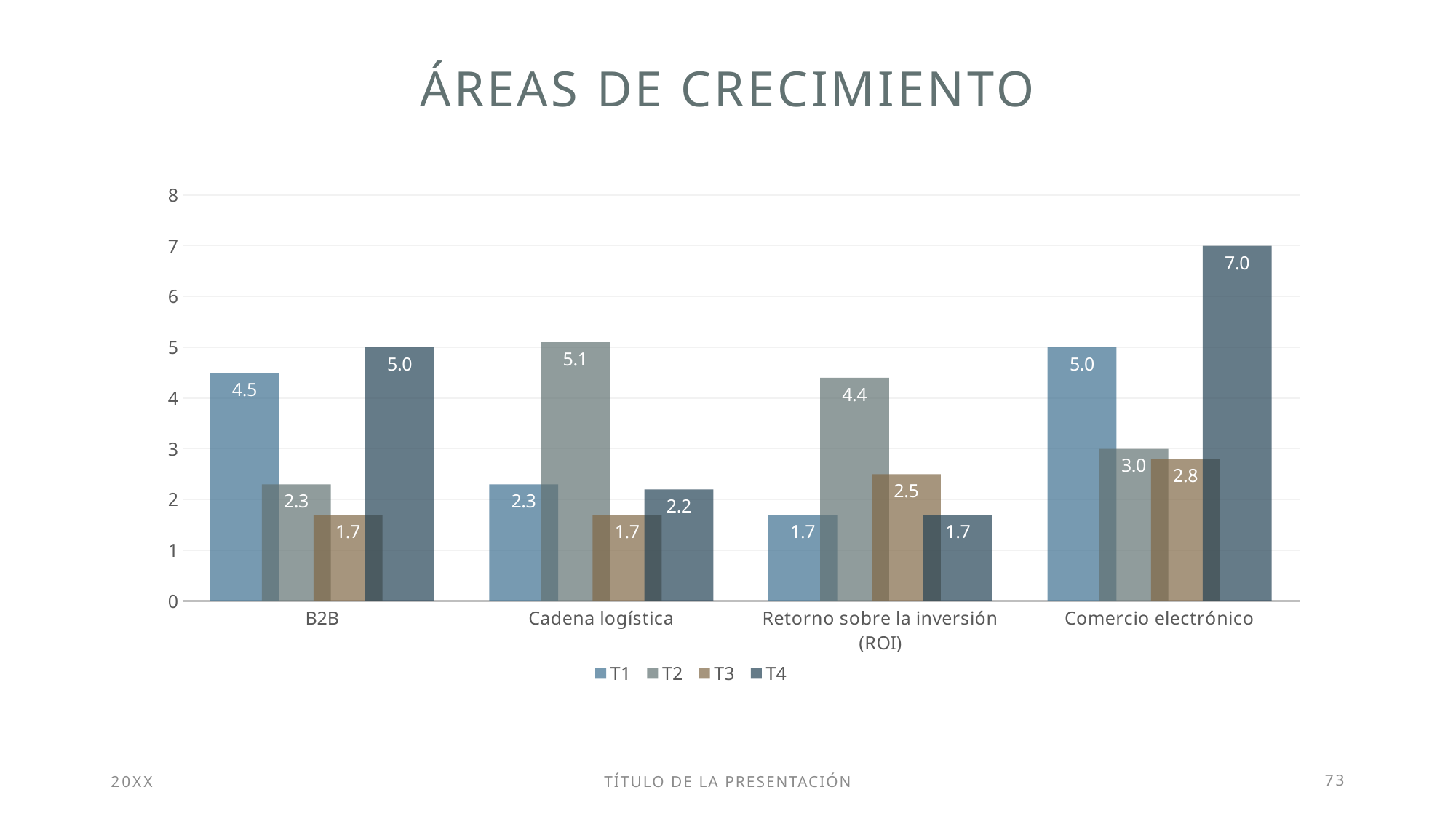
What is the T3 value for Retorno sobre la inversión (ROI)? 2.5 What kind of chart is shown on the slide? Bar chart How many categories are shown on the x axis? 4 What is the T2 value for Cadena logística? 5.1 What is the difference between the T4 and T1 values for Comercio electrónico? 2.0 What is the T4 value for Comercio electrónico? 7.0 What is the title of the chart? ÁREAS DE CRECIMIENTO Which category has the highest T4 value? Comercio electrónico Which category has the lowest T1 value? Retorno sobre la inversión (ROI) Is the T2 value for Retorno sobre la inversión (ROI) greater or less than 4? greater Which is larger for B2B: the T1 value or the T2 value? T1 How many series does the legend list? 4